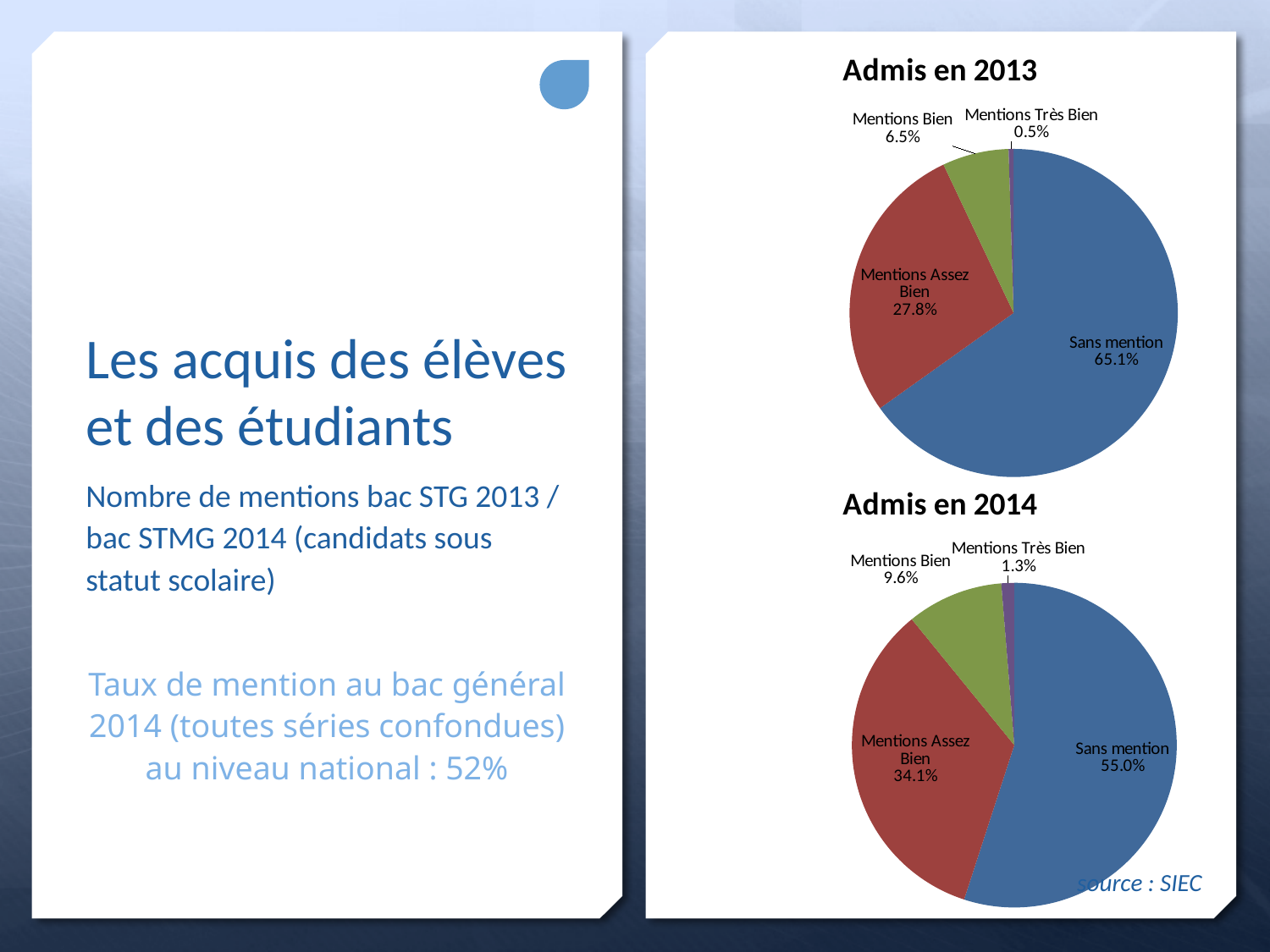
In the 'Admis en 2013' chart, which category has the largest slice? Sans mention In the 'Admis en 2014' chart, what is the difference between 'Sans mention' and 'Mentions Assez Bien'? 20.9% In the 'Admis en 2014' chart, what is the value for 'Mentions Très Bien'? 1.3% In the 'Admis en 2013' chart, what colour is the 'Mentions Assez Bien' slice? Red In the 'Admis en 2013' chart, what is the value for 'Mentions Assez Bien'? 27.8% In the 'Admis en 2013' chart, what share does 'Sans mention' have? 65.1% What type of chart is 'Admis en 2014'? Pie chart What is the title of the top chart on the slide? Admis en 2013 In the 'Admis en 2014' chart, what is the value for 'Mentions Bien'? 9.6% How many slices does the 'Admis en 2013' chart have? 4 In the 'Admis en 2014' chart, which category has the smallest slice? Mentions Très Bien Which is larger: 'Mentions Bien' in the 'Admis en 2013' chart or 'Mentions Bien' in the 'Admis en 2014' chart? Admis en 2014